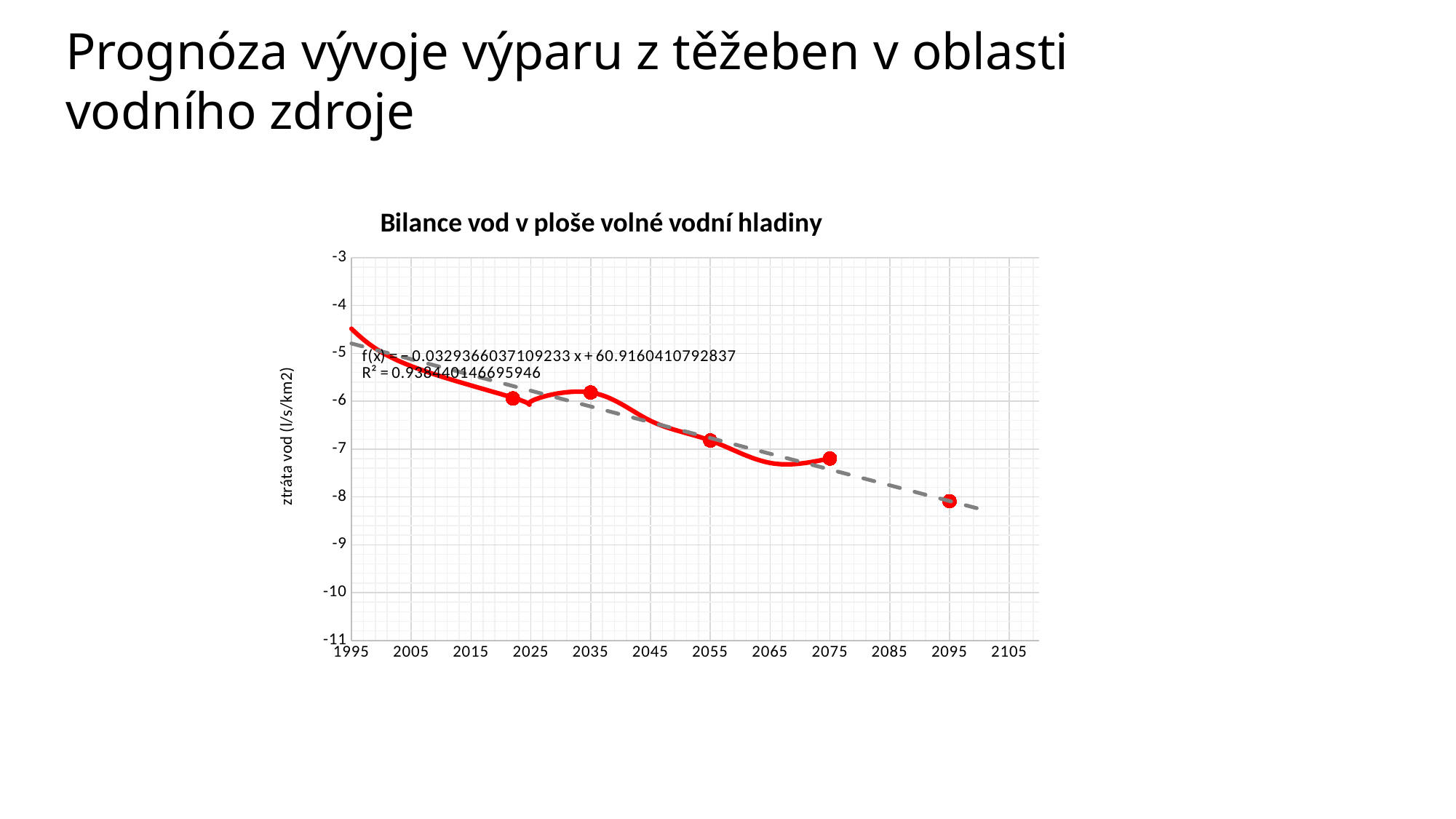
What kind of chart is shown on the slide? line chart How many red data point markers are plotted on the chart? 5 What is the label of the vertical axis? ztráta vod (l/s/km2) What R² value is printed for the trendline on the chart? 0.938440146695946 Is the value for 2075 greater or less than -7? less Which plotted year has the lowest value? 2095 Do the plotted values rise or fall as the year increases along the x axis? fall Is the value for 2075 greater or less than -8? greater Which has the larger value, the point at 2035 or the point at 2095? 2035 Is the value for 2035 greater or less than -6? greater What is the title of the chart? Bilance vod v ploše volné vodní hladiny